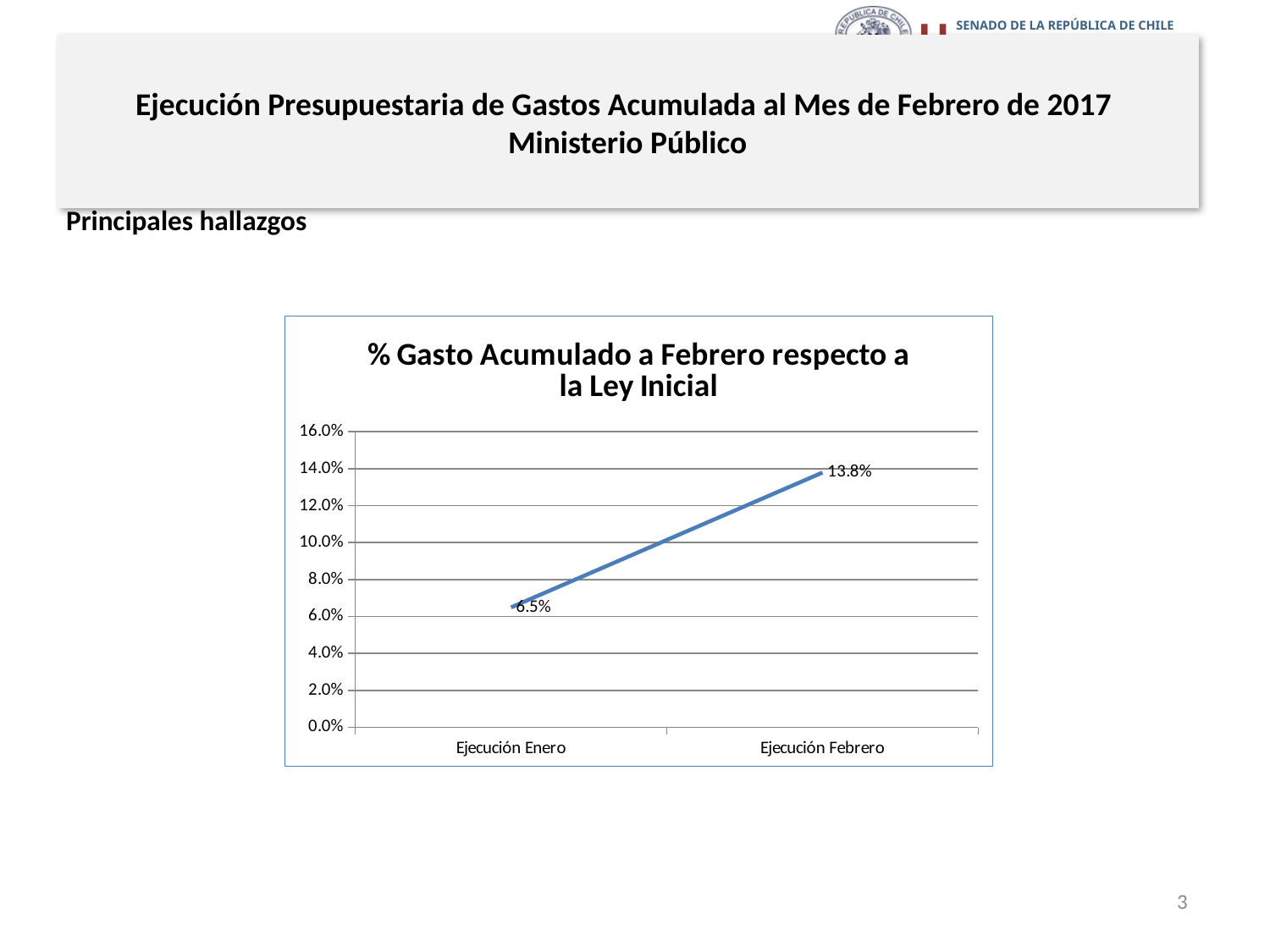
Do the values rise or fall from Ejecución Enero to Ejecución Febrero? rise What is the value for Ejecución Febrero? 13.8% What is the difference between the values for Ejecución Febrero and Ejecución Enero? 7.3% What is the title of the chart? % Gasto Acumulado a Febrero respecto a la Ley Inicial Is the value for Ejecución Enero greater or less than 8.0%? less Which is larger, the value for Ejecución Enero or Ejecución Febrero? Ejecución Febrero Which category has the lowest value? Ejecución Enero Is the value for Ejecución Febrero greater or less than 12.0%? greater What is the value for Ejecución Enero? 6.5% Which category has the highest value? Ejecución Febrero How many categories are shown on the x axis? 2 What kind of chart is shown on the slide? line chart